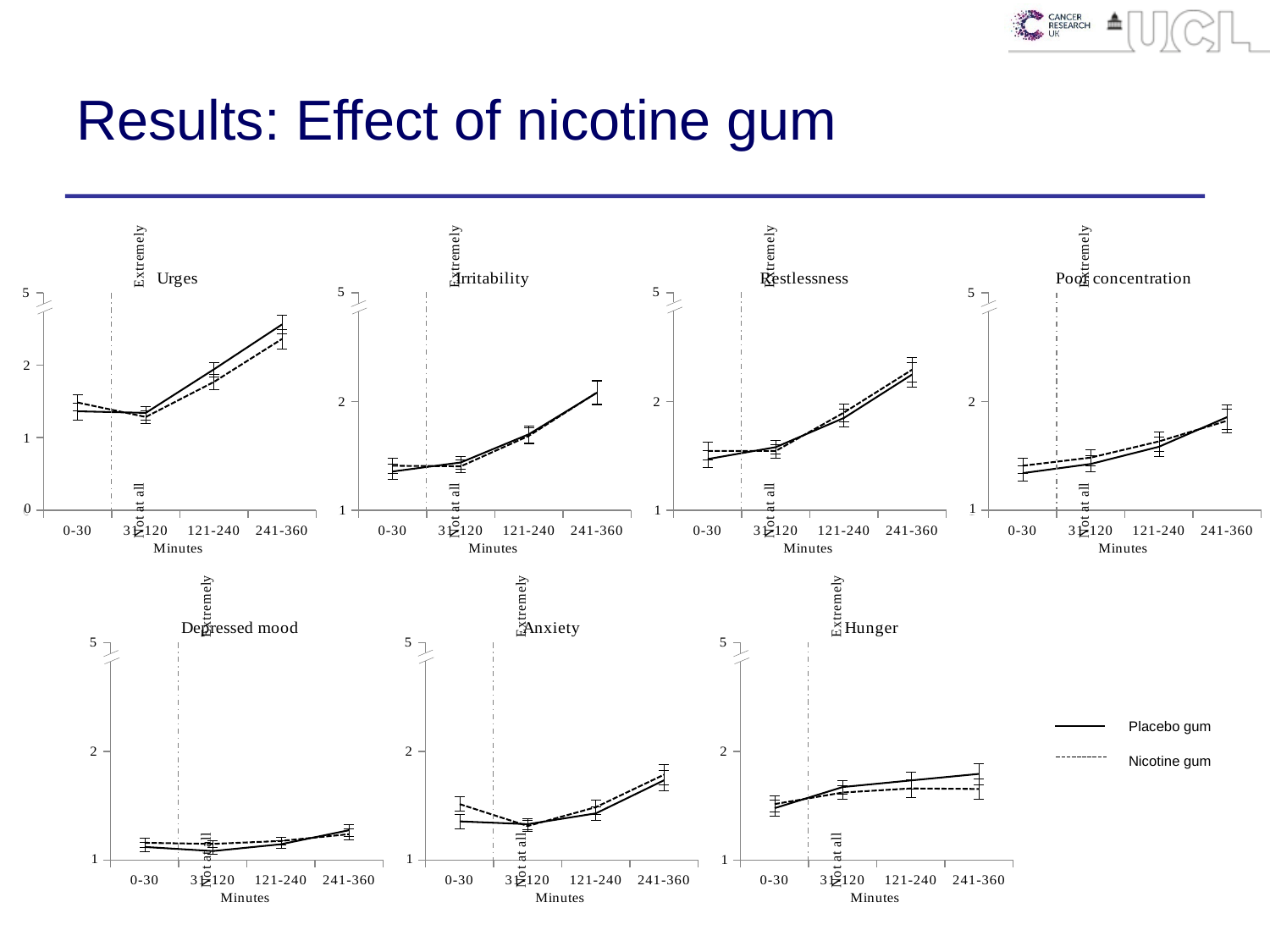
In the Depressed mood chart, is the Placebo gum value for 241-360 minutes greater or less than 2? less What kind of chart is the Urges chart? line chart In the Restlessness chart, which time period has the highest value for Placebo gum? 241-360 Which series is drawn with a dashed line according to the legend? Nicotine gum In the Restlessness chart, is the Nicotine gum value for 241-360 minutes greater or less than 2? greater In the Urges chart, is the Placebo gum value for 241-360 minutes greater or less than 2? greater How many series does the legend list? 2 In the Hunger chart, at 241-360 minutes, which series has the higher value, Placebo gum or Nicotine gum? Placebo gum In the Restlessness chart, do the values rise or fall from 0-30 to 241-360 minutes? rise How many time-period categories are shown on the x axis of the Restlessness chart? 4 How many separate charts are shown on the slide? 7